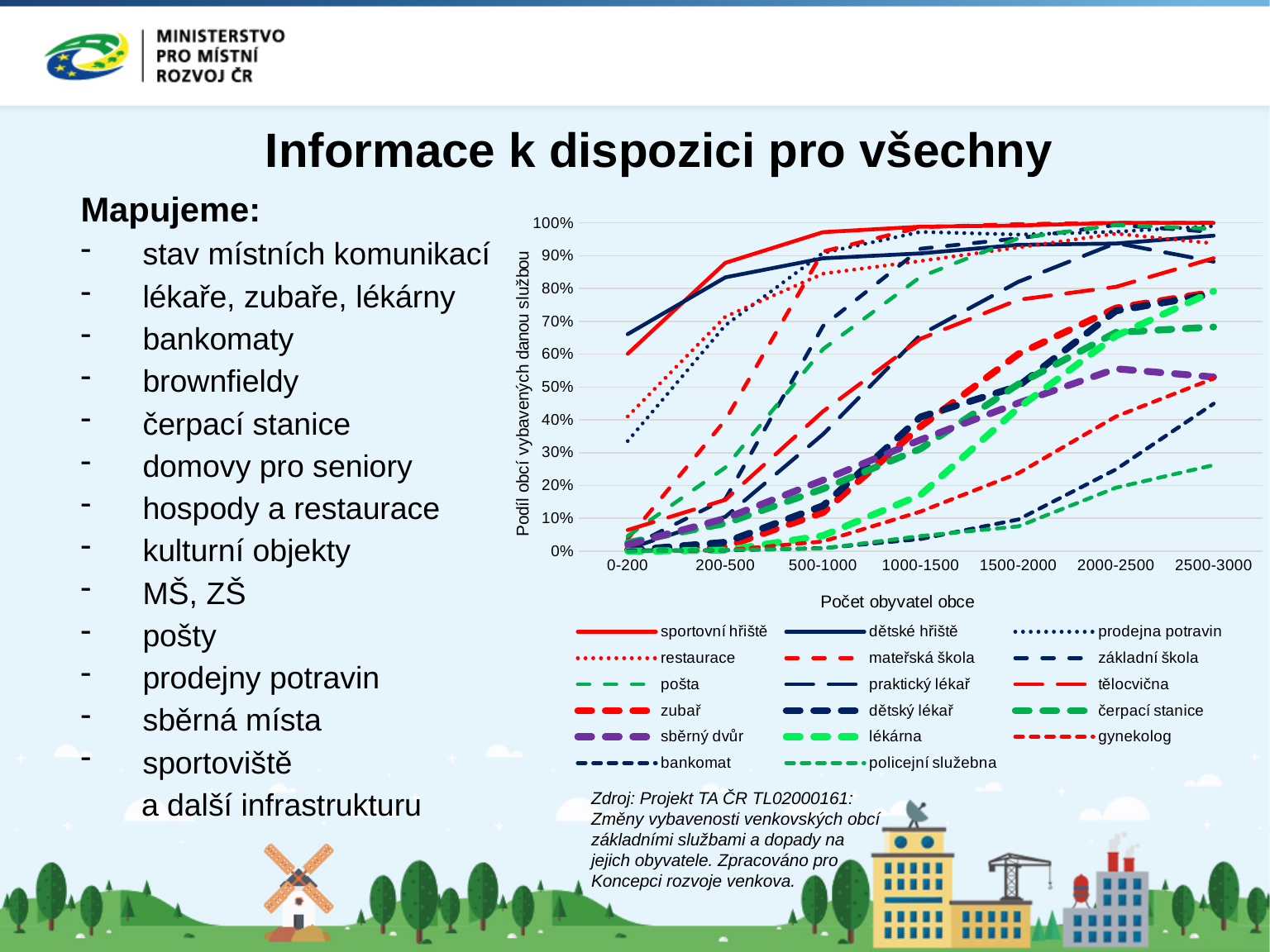
Is the value for sportovní hřiště in the 0-200 category greater or less than 50%? greater Is the value for policejní služebna in the 2500-3000 category greater or less than 30%? less Do the values for sportovní hřiště rise or fall as the population category increases along the x axis? rise Is the value for dětské hřiště in the 0-200 category greater or less than 60%? greater What kind of chart is shown on the slide? line chart In the 2500-3000 category, which is larger: the value for bankomat or the value for policejní služebna? bankomat How many population categories are shown on the x axis of the chart? 7 Which series has the lowest value in the 2500-3000 category? policejní služebna How many series does the chart's legend list? 17 What is the title of the chart's x axis? Počet obyvatel obce